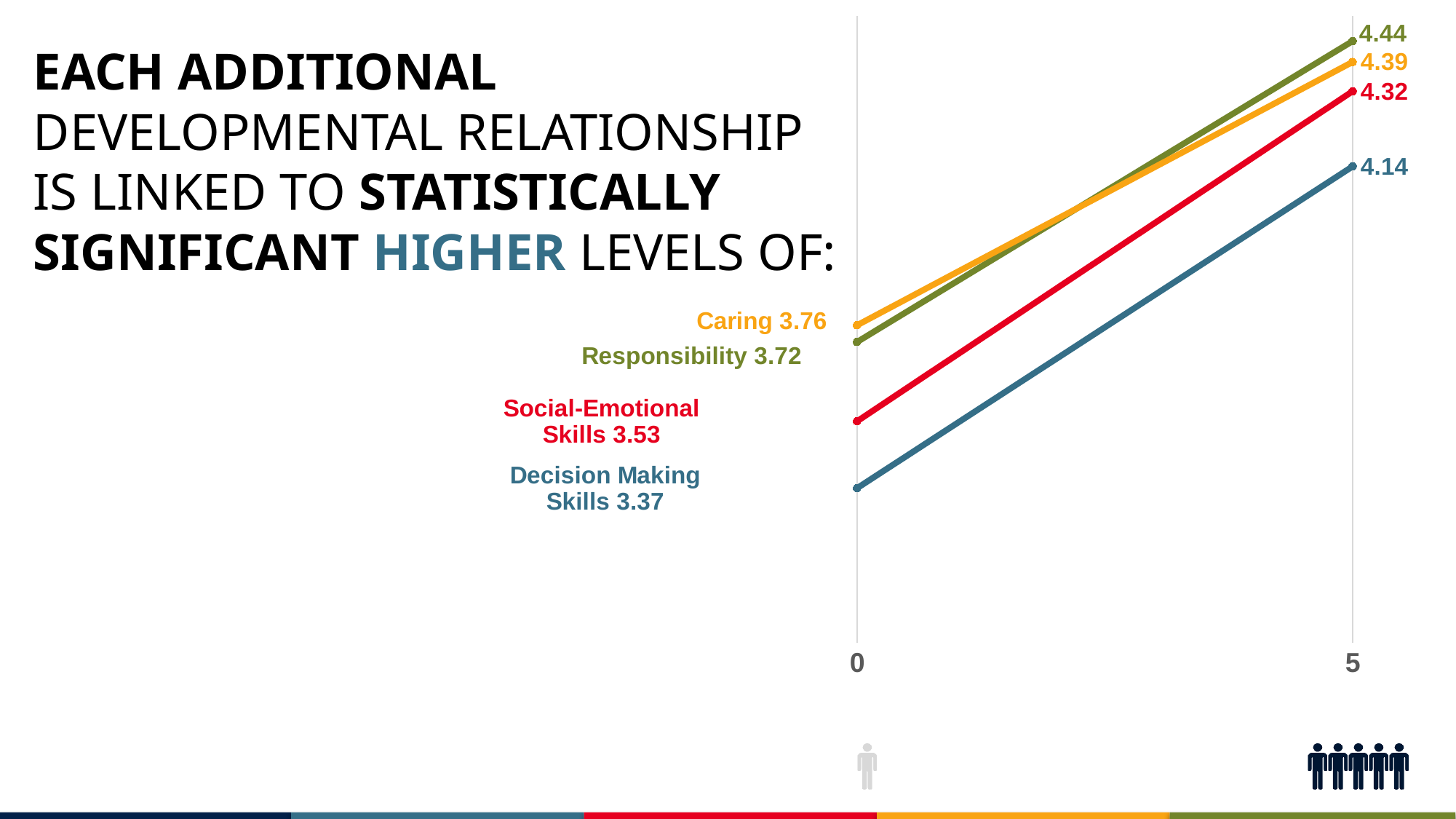
What kind of chart is shown on the slide? Line chart What is the difference between the Caring and Responsibility values at 5 developmental relationships? 0.05 How many series are plotted on the chart? 4 At 0 developmental relationships, which is larger: Caring or Social-Emotional Skills? Caring What is the value for Decision Making Skills at 0 developmental relationships? 3.37 What is the value for Social-Emotional Skills at 5 developmental relationships? 4.32 What is the value for Responsibility at 5 developmental relationships? 4.44 Do the values for Social-Emotional Skills rise or fall from 0 to 5 developmental relationships? Rise What is the difference between the Decision Making Skills values at 5 and at 0 developmental relationships? 0.77 Which series has the lowest value at 0 developmental relationships? Decision Making Skills Which series has the highest value at 5 developmental relationships? Responsibility What is the value for Caring at 0 developmental relationships? 3.76